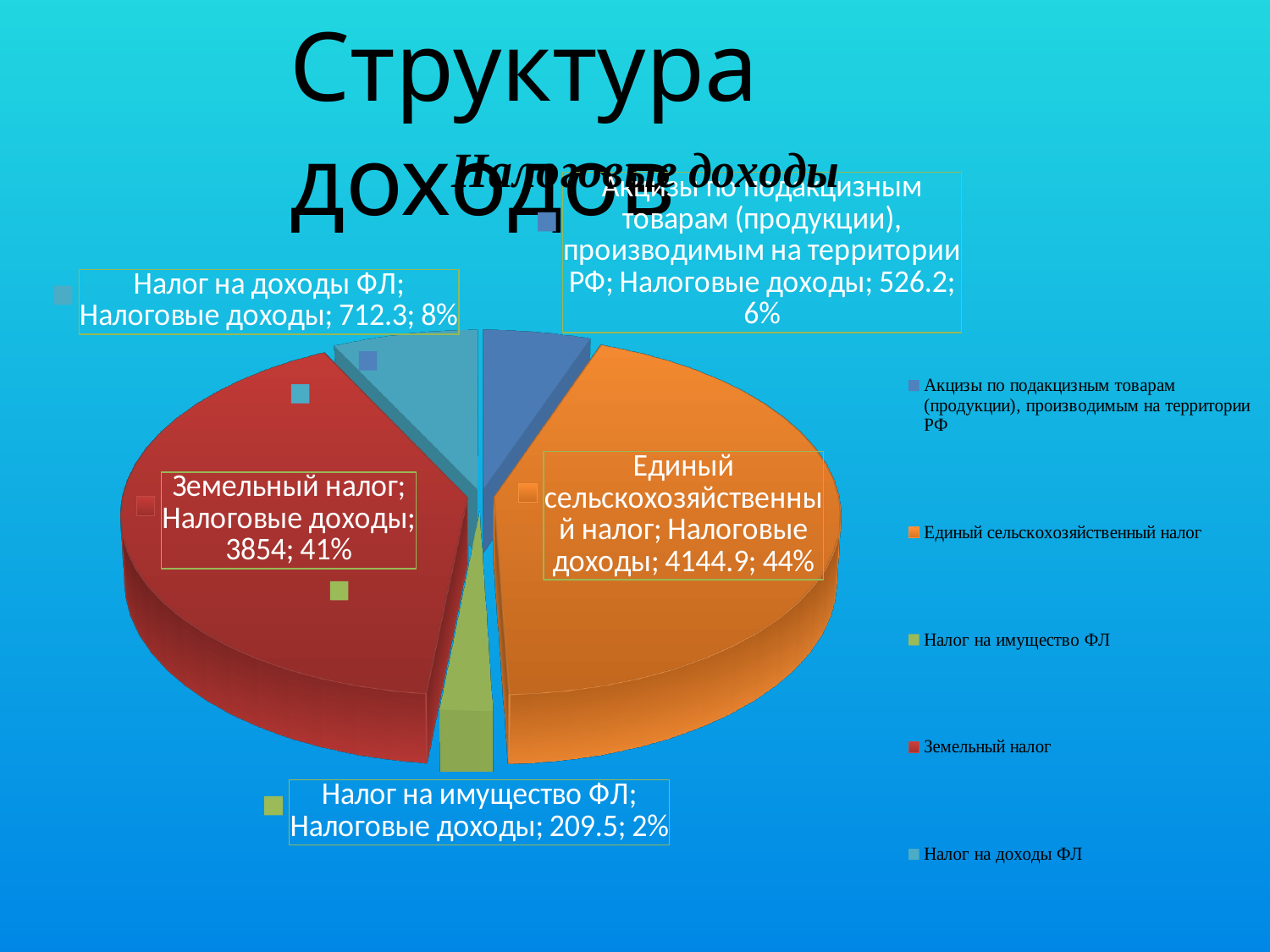
Which is larger: the value for Налог на доходы ФЛ or the value for Налог на имущество ФЛ? Налог на доходы ФЛ What is the value for Налог на имущество ФЛ? 209.5 What percentage share does Земельный налог have in the pie? 41% What is the difference between the values for Налог на доходы ФЛ and Акцизы по подакцизным товарам (продукции), производимым на территории РФ? 186.1 What kind of chart is shown on the slide? pie chart Which category has the smallest slice of the pie? Налог на имущество ФЛ What is the value for Земельный налог? 3854 Which category has the largest slice of the pie? Единый сельскохозяйственный налог What is the value for Налог на доходы ФЛ? 712.3 What is the value for Единый сельскохозяйственный налог? 4144.9 How many categories does the pie chart have? 5 What percentage share does Акцизы по подакцизным товарам (продукции), производимым на территории РФ have in the pie? 6%